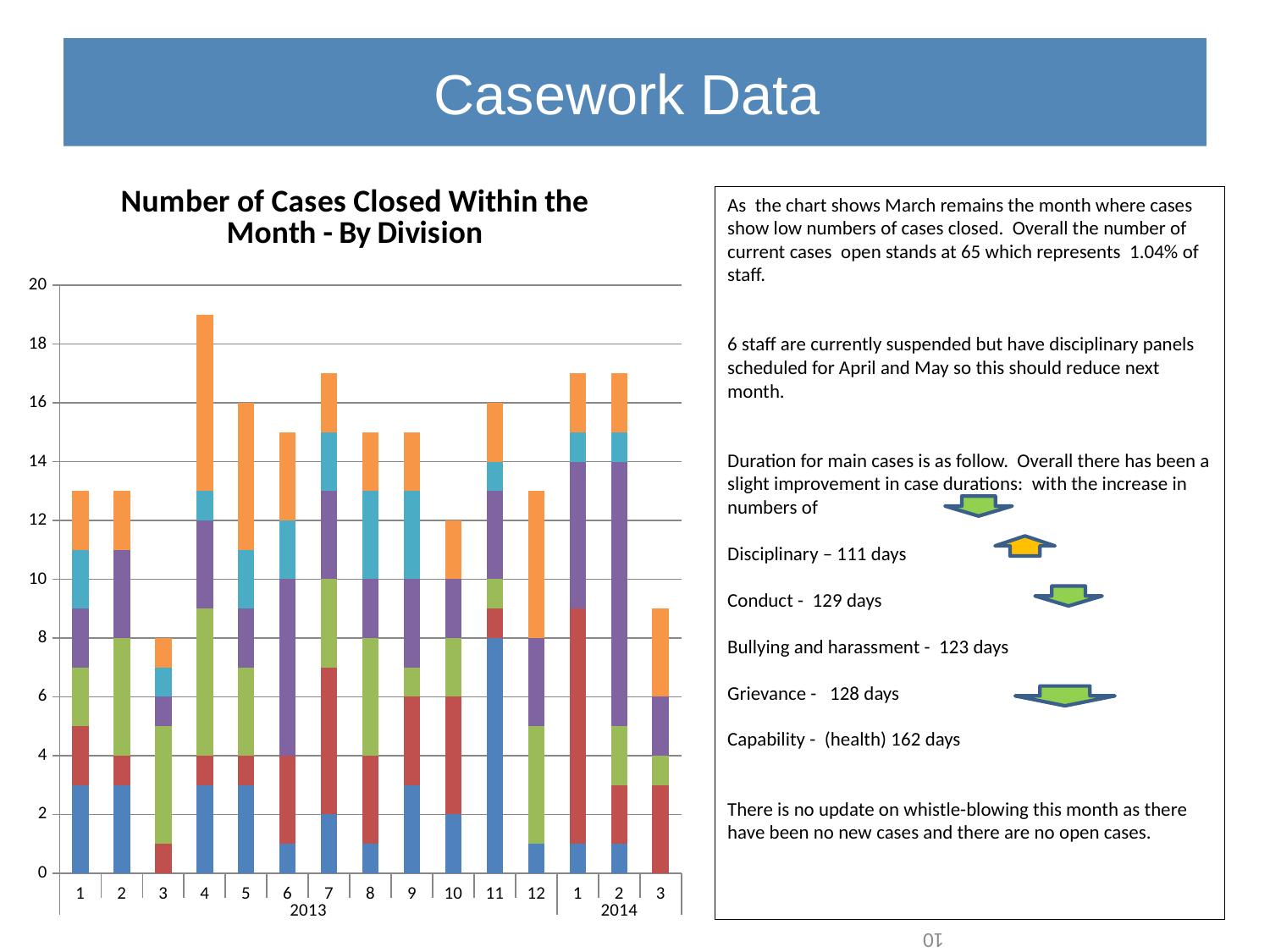
Which month has the shortest bar (fewest cases closed)? Month 3 of 2013 How many monthly bars are plotted in the chart? 15 What is the total height of the stacked bar for month 10 of 2013? 12 Is the total for month 3 of 2013 greater or less than 10? less Which bar is taller: month 10 of 2013 or month 11 of 2013? Month 11 of 2013 What kind of chart is shown on the slide? Stacked bar chart Is the total for month 12 of 2013 greater or less than 14? less Is the total for month 1 of 2014 greater or less than 16? greater What is the title of the chart? Number of Cases Closed Within the Month - By Division Which month has the tallest bar (most cases closed)? Month 4 of 2013 What is the total height of the stacked bar for month 5 of 2013? 16